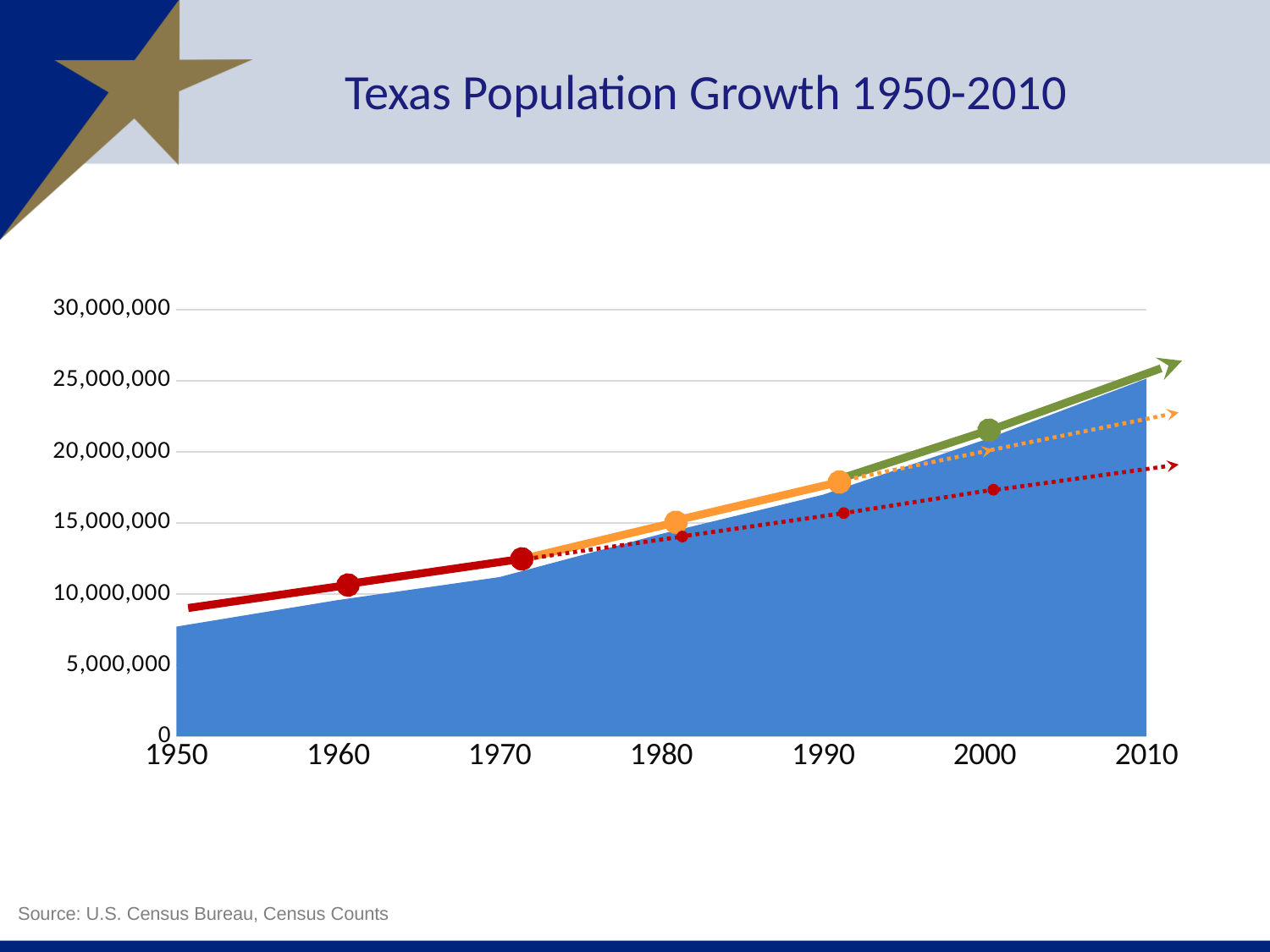
Which year has the highest population value? 2010 Which year has the larger population value, 1970 or 1990? 1990 Is the population value for 2000 greater or less than 25,000,000? less Do the population values rise or fall from 1950 to 2010? Rise Is the population value for 1950 greater or less than 10,000,000? less How many years are labelled on the x axis? 7 What is the title of the chart? Texas Population Growth 1950-2010 What is the highest value labelled on the y axis? 30,000,000 Which year has the lowest population value? 1950 Is the population value for 2010 greater or less than 20,000,000? greater What kind of chart is shown on the slide? Area chart